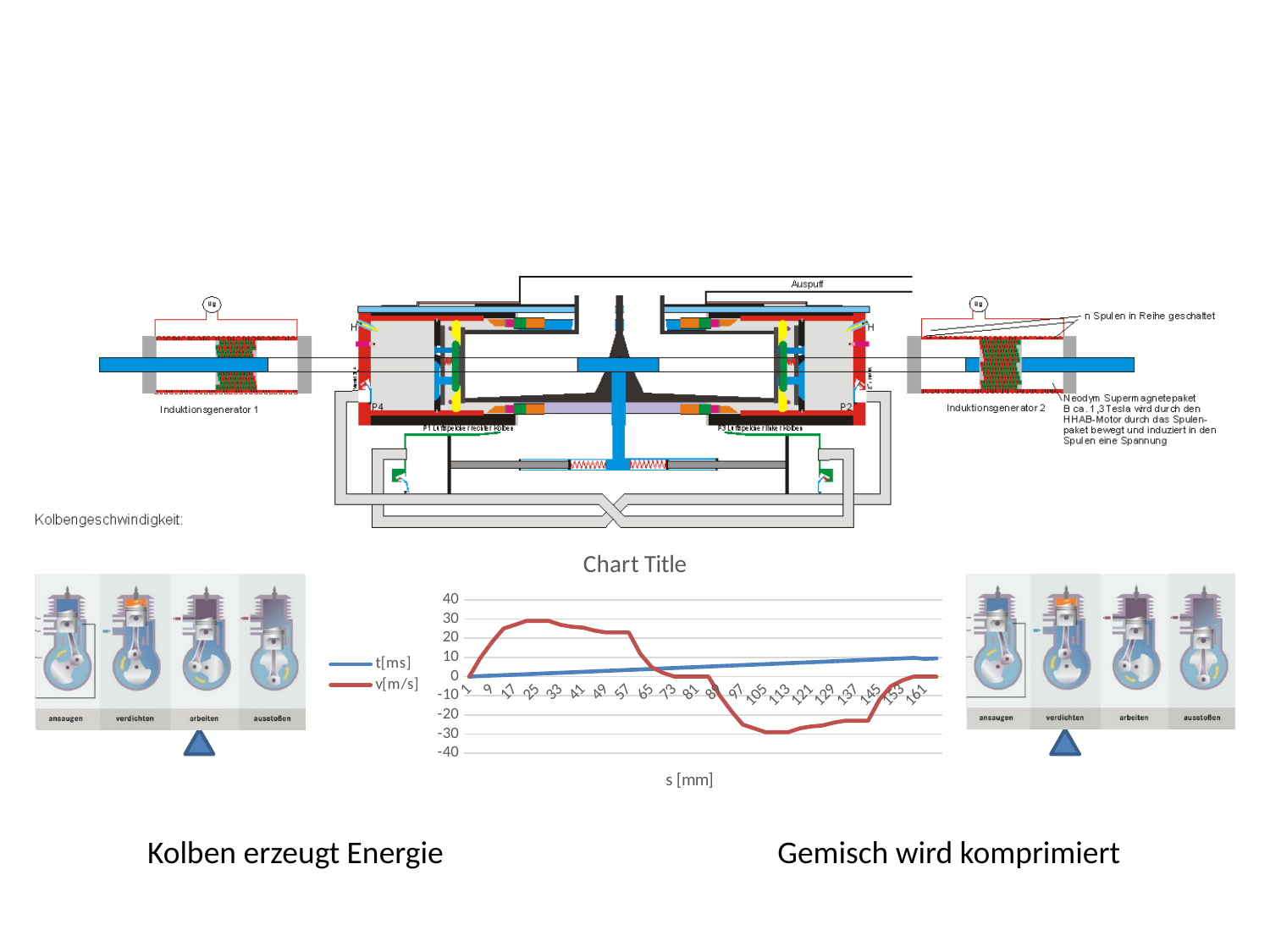
Is the value of v[m/s] at s = 57 greater or less than 10? greater What is the highest value shown on the chart's y axis? 40 What label is shown on the chart's x axis? s [mm] At s = 25, which series has the larger value, t[ms] or v[m/s]? v[m/s] At s = 105, which series has the larger value, t[ms] or v[m/s]? t[ms] What is the title shown above the chart? Chart Title How many series does the chart's legend list? 2 Is the value of v[m/s] at s = 105 greater or less than -20? less Does the t[ms] series rise or fall along the x axis? rise Is the value of t[ms] at s = 161 greater or less than 0? greater What kind of chart is shown on the slide? line chart